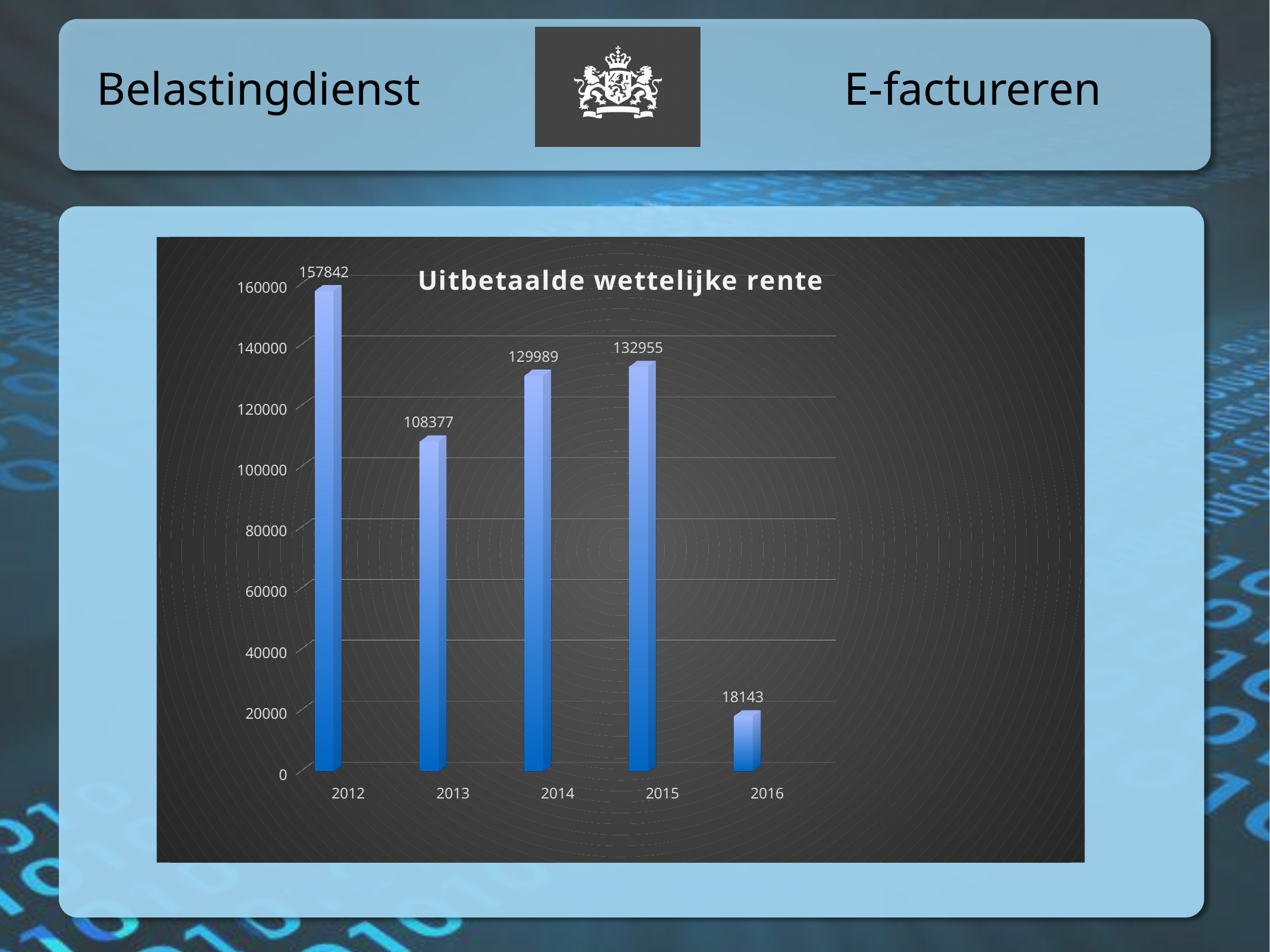
What is the value for 2016? 18143 What is the title of the chart? Uitbetaalde wettelijke rente What is the difference between the values for 2015 and 2014? 2966 What is the difference between the values for 2012 and 2013? 49465 What is the value for 2013? 108377 What kind of chart is shown on the slide? bar chart Which year has the lowest value? 2016 How many years are shown on the x axis? 5 What is the value for 2012? 157842 Which year has the highest value? 2012 Which is larger, the value for 2014 or the value for 2013? 2014 Is the value for 2015 greater or less than 120000? greater